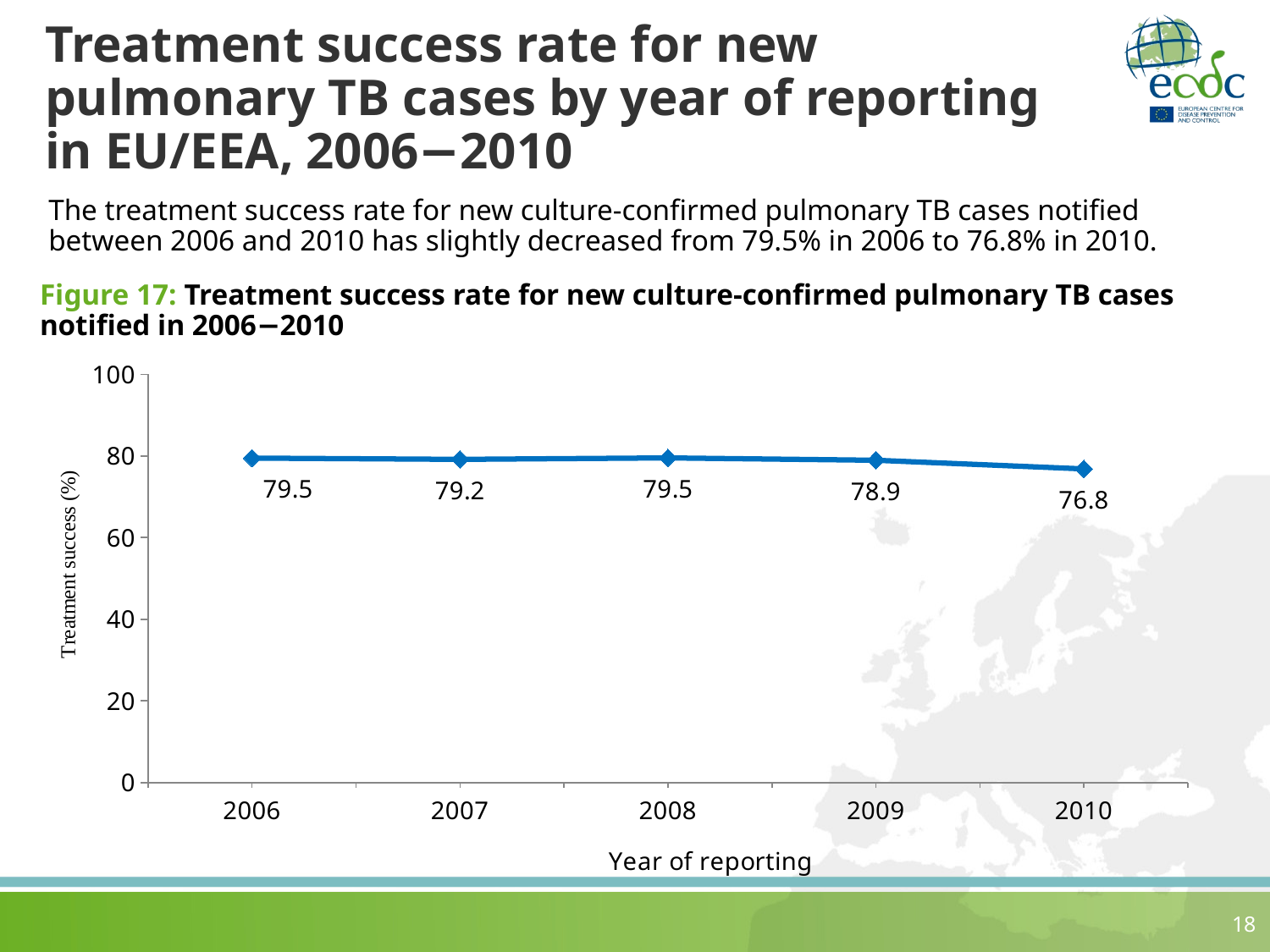
What is the difference between the treatment success rate in 2006 and in 2010? 2.7 What kind of chart is shown on the slide? line chart What is the treatment success rate for 2010? 76.8 Which year has a higher treatment success rate, 2007 or 2009? 2007 Which year has the lowest treatment success rate? 2010 What is the label of the y axis? Treatment success (%) What is the treatment success rate for 2009? 78.9 What is the treatment success rate for 2006? 79.5 What is the label of the x axis? Year of reporting Does the treatment success rate rise or fall from 2008 to 2010? fall How many years are plotted on the chart? 5 Is the treatment success rate for 2008 greater or less than 80? less